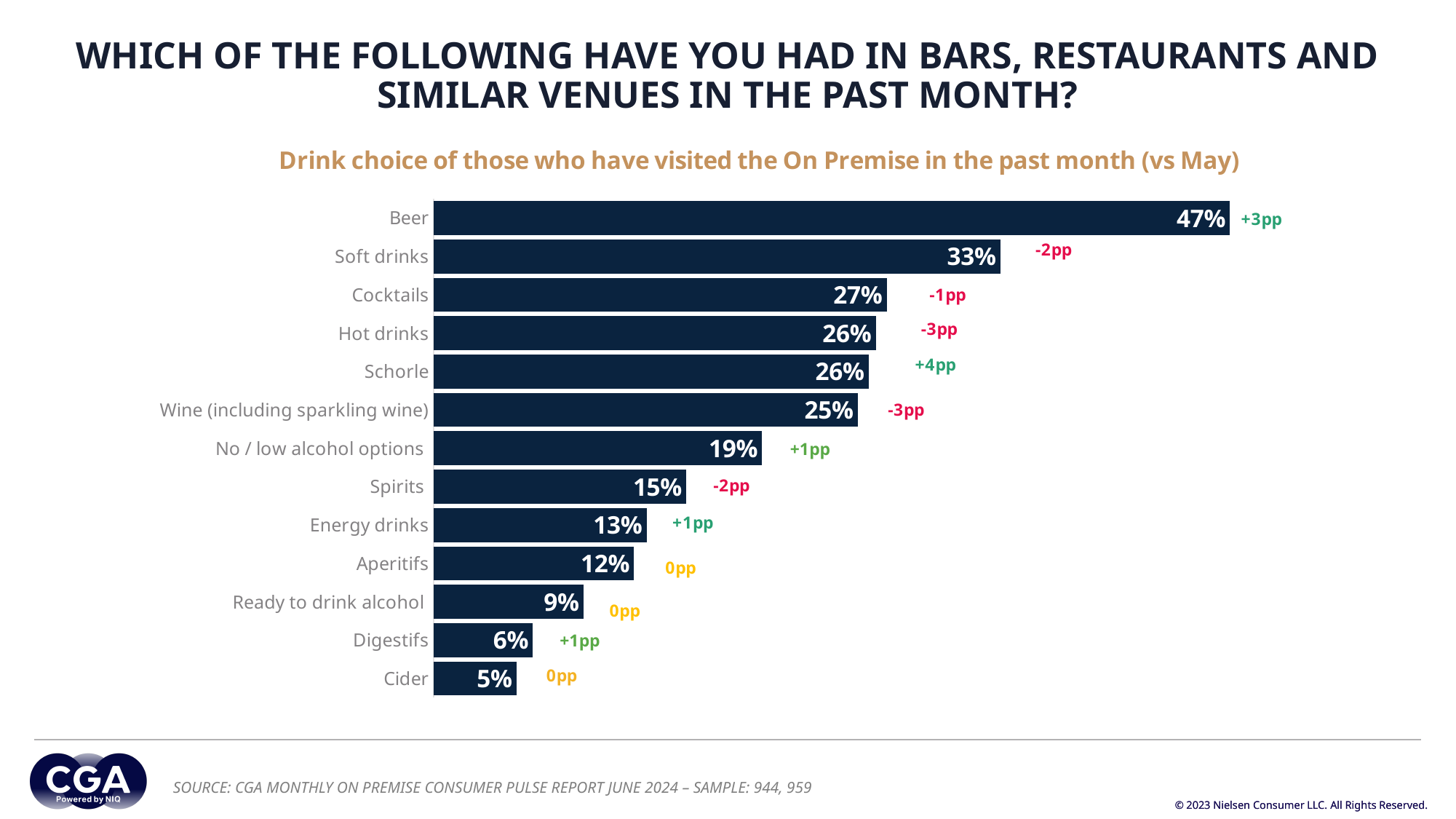
What percentage of respondents had beer in bars, restaurants and similar venues in the past month? 47% Which drink category has the lowest value on the chart? Cider What is the value shown for Soft drinks? 33% What percentage is shown for No / low alcohol options? 19% What is the change versus May shown next to Hot drinks? -3pp What is the difference between the values for Beer and Soft drinks? 14 percentage points What is the subtitle of the chart? Drink choice of those who have visited the On Premise in the past month (vs May) What is the change versus May shown next to Schorle? +4pp How many drink categories are shown on the chart? 13 What kind of chart is shown on the slide? Bar chart Which has a higher value, Spirits or Energy drinks? Spirits Which drink category has the highest value on the chart? Beer